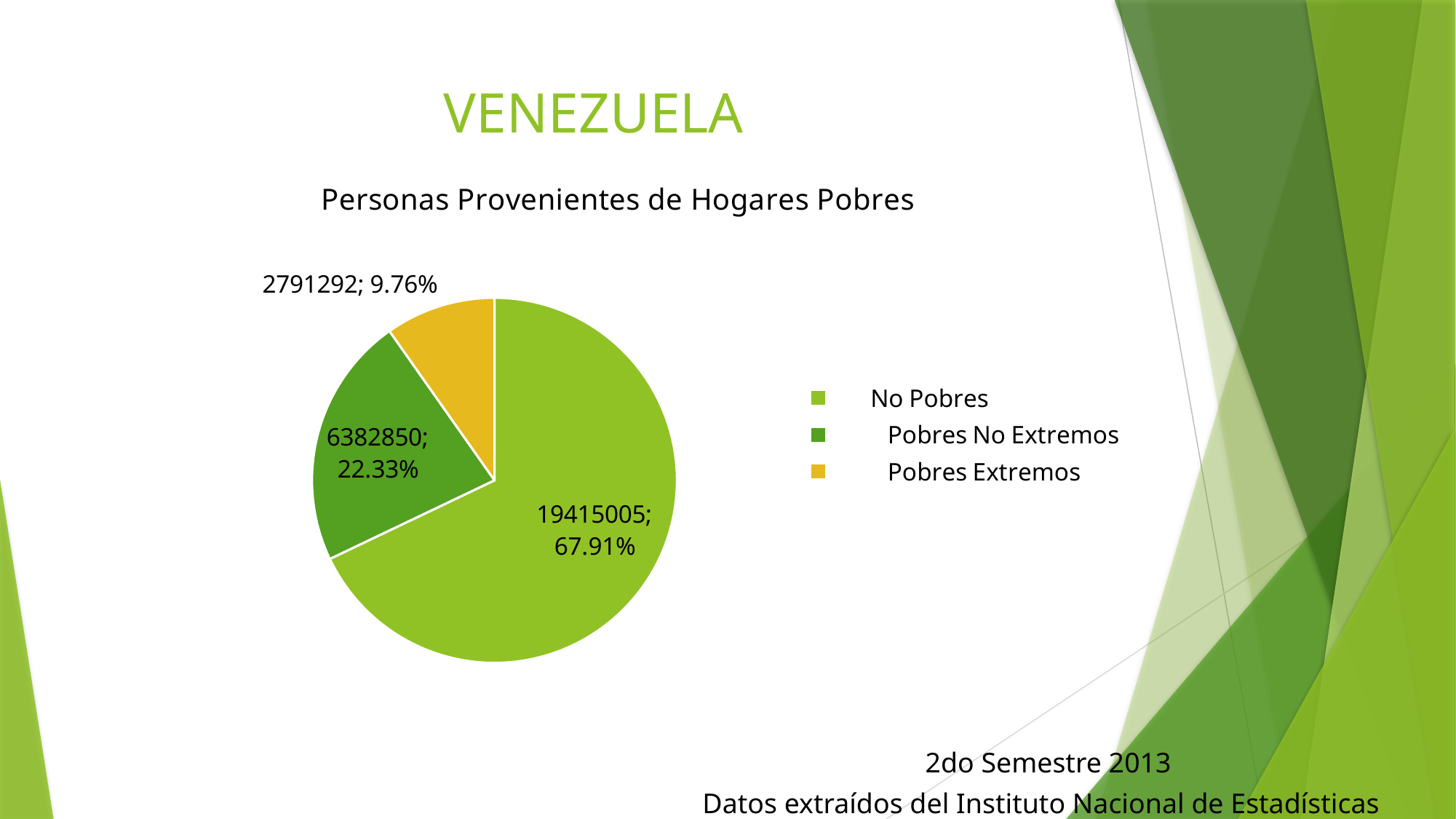
Which category has the largest slice? No Pobres What is the difference between the values for Pobres No Extremos and Pobres Extremos? 3591558 What share of the pie does Pobres Extremos represent? 9.76% What is the value for Pobres Extremos? 2791292 What share of the pie does Pobres No Extremos represent? 22.33% How many slices does the pie chart have? 3 What is the value for Pobres No Extremos? 6382850 Which category has the smallest slice? Pobres Extremos What is the title of the chart? Personas Provenientes de Hogares Pobres How many entries does the legend list? 3 What is the value for No Pobres? 19415005 What kind of chart is shown on the slide? pie chart